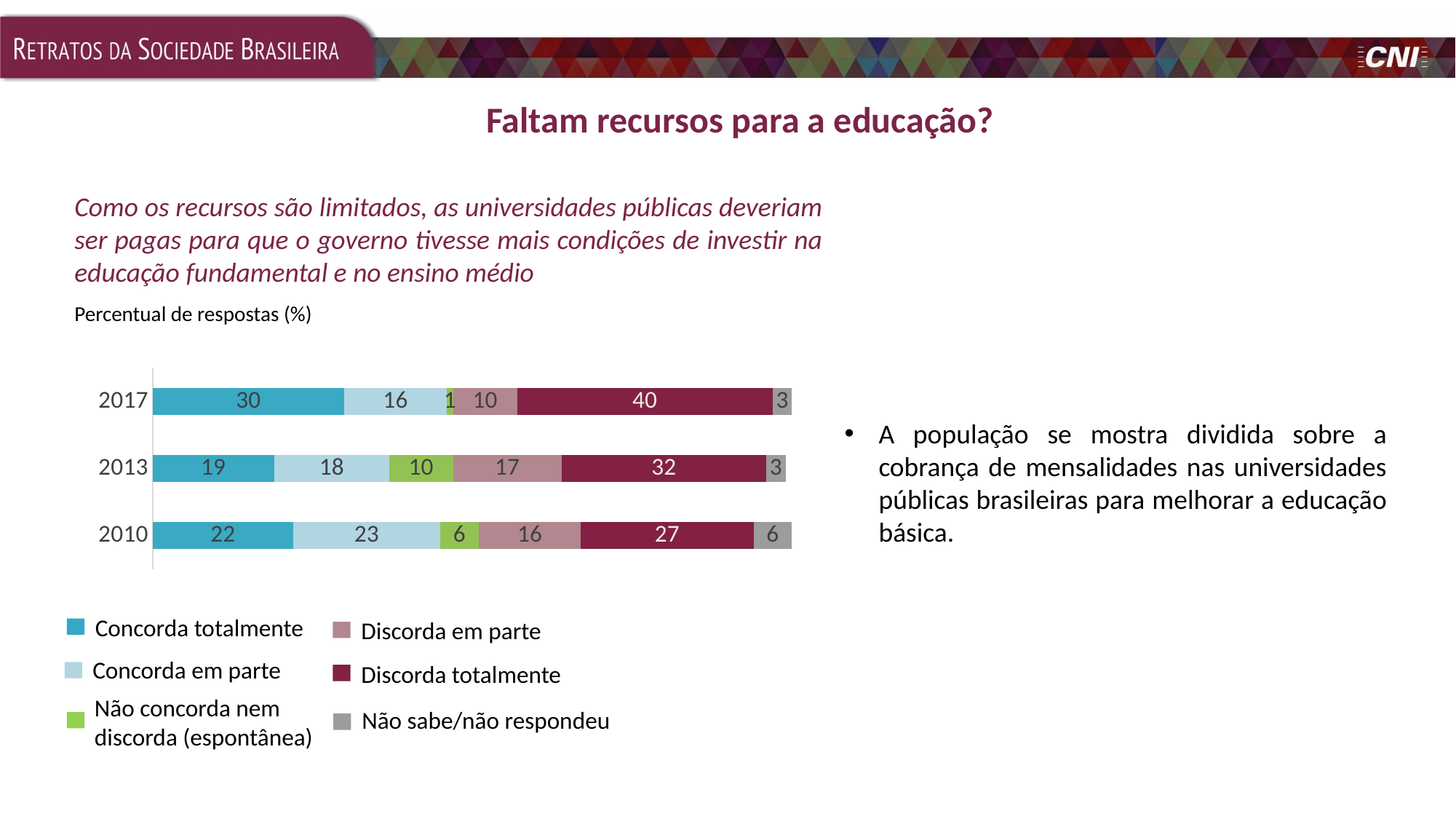
In which year is the value for "Concorda totalmente" highest? 2017 In which year is the value for "Discorda totalmente" lowest? 2010 What is the value for "Concorda em parte" in 2010? 23 What is the value for "Discorda totalmente" in 2017? 40 What is the total of the stacked bar for 2013? 99 What type of chart is shown on the slide? Stacked bar chart What is the label shown above the chart describing the unit of the values? Percentual de respostas (%) What is the value for "Não concorda nem discorda (espontânea)" in 2013? 10 How many series does the legend list? 6 Which is larger in 2013: "Concorda totalmente" or "Discorda em parte"? Concorda totalmente What is the difference between the "Discorda totalmente" values for 2017 and 2013? 8 How many years (categories) are shown in the chart? 3